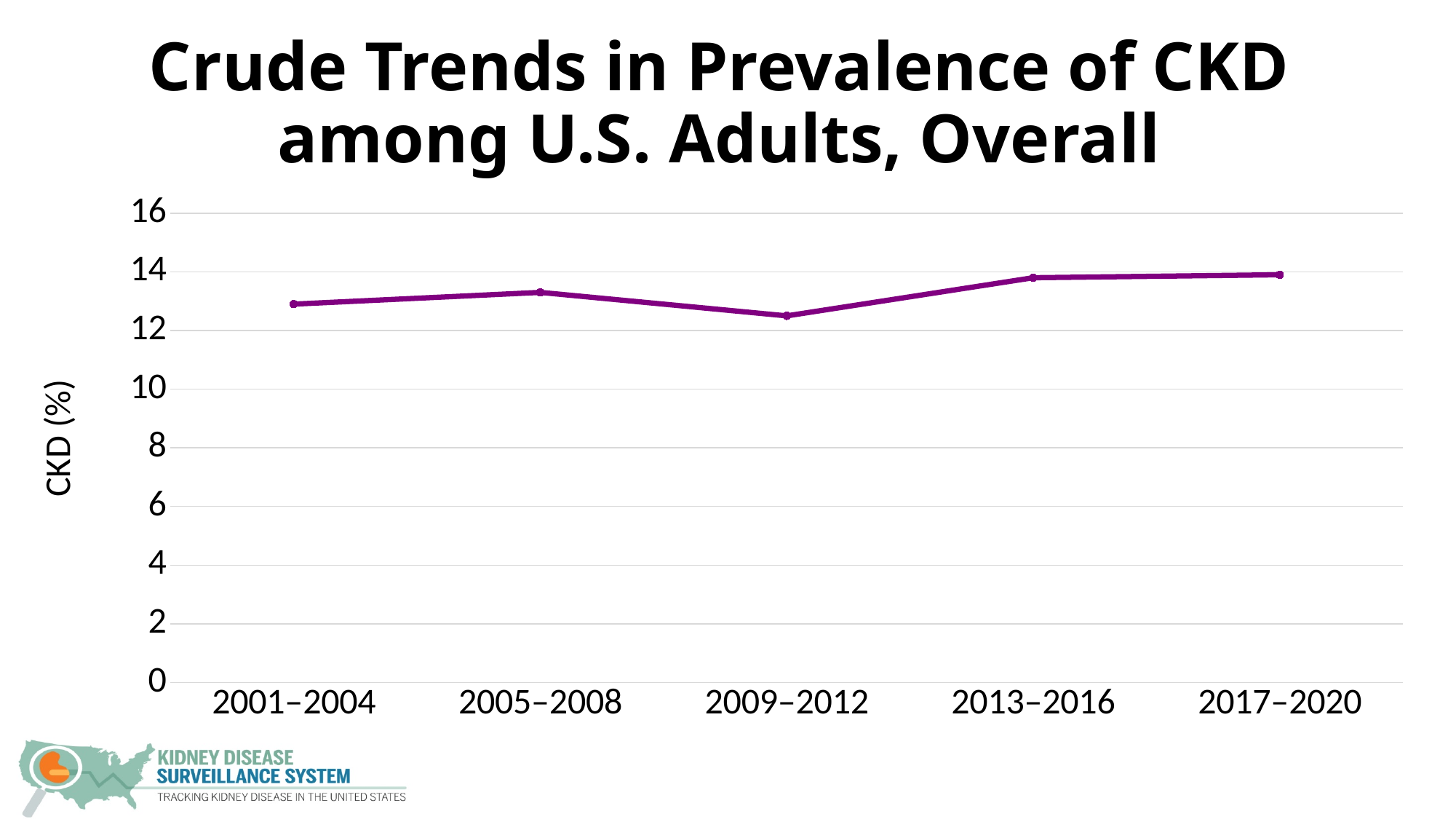
Is the CKD prevalence for 2009–2012 greater or less than 12? greater How many time periods are plotted along the x axis? 5 Is the CKD prevalence for 2001–2004 greater or less than 14? less What kind of chart is shown on the slide? line chart What is the label on the y axis? CKD (%) Which time period has the lowest CKD prevalence? 2009–2012 Does the CKD prevalence rise or fall from 2009–2012 to 2013–2016? rise Which has the higher CKD prevalence, 2009–2012 or 2013–2016? 2013–2016 What is the title of the chart? Crude Trends in Prevalence of CKD among U.S. Adults, Overall Is the CKD prevalence for 2013–2016 greater or less than 12? greater Which has the higher CKD prevalence, 2005–2008 or 2009–2012? 2005–2008